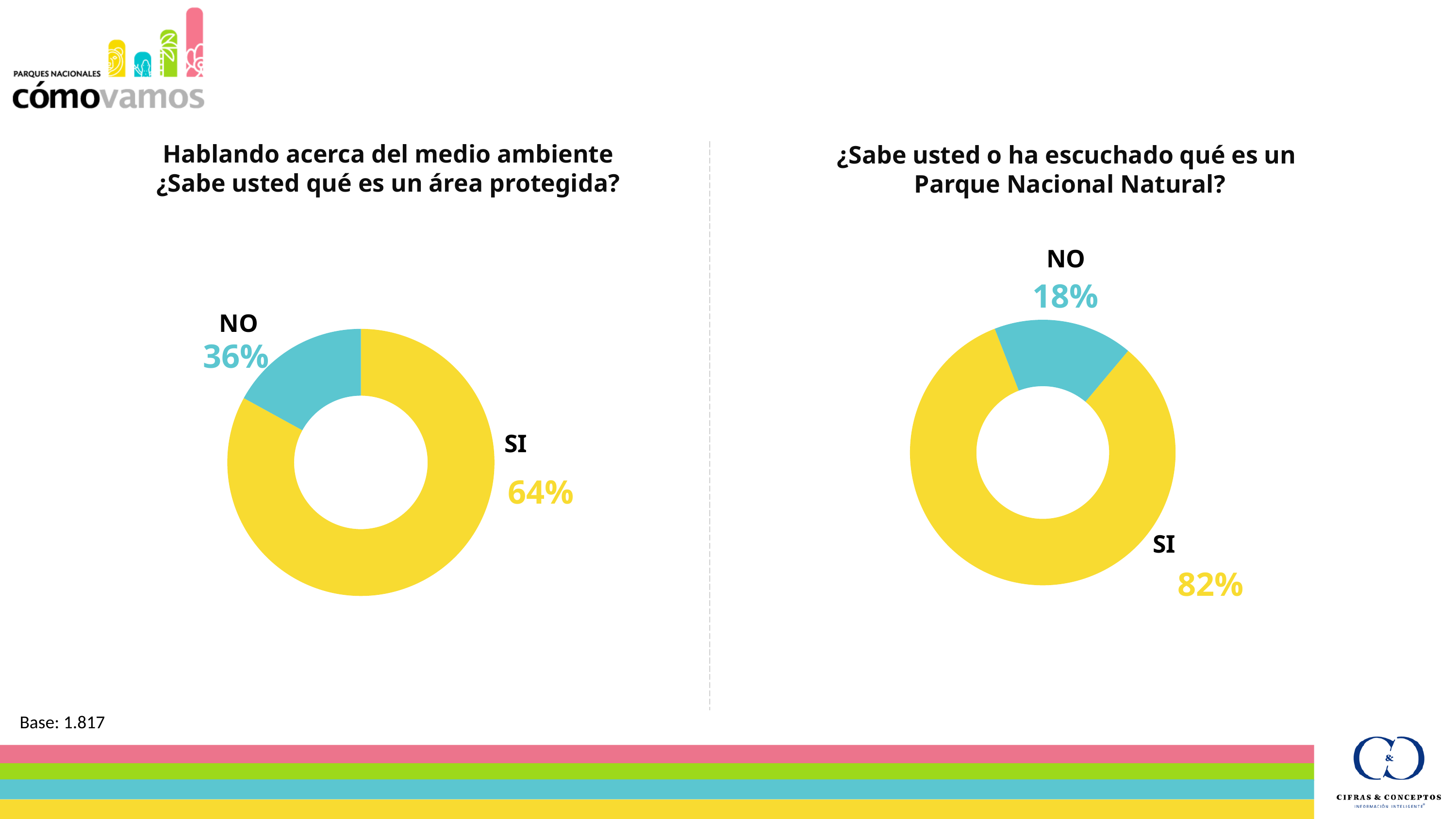
In the left chart (¿Sabe usted qué es un área protegida?), which answer has the largest share? SI In the right chart (¿Sabe usted o ha escuchado qué es un Parque Nacional Natural?), which answer has the smallest share? NO In the left chart (¿Sabe usted qué es un área protegida?), what percentage answered SI? 64% In the right chart (¿Sabe usted o ha escuchado qué es un Parque Nacional Natural?), what percentage answered SI? 82% In the left chart (¿Sabe usted qué es un área protegida?), what is the difference in percentage points between SI and NO? 28 Which chart has the larger SI share, the left chart (área protegida) or the right chart (Parque Nacional Natural)? The right chart (Parque Nacional Natural) In the right chart (¿Sabe usted o ha escuchado qué es un Parque Nacional Natural?), what percentage answered NO? 18% What kind of chart is used on the left side of the slide? Doughnut (pie) chart How many categories does the right chart (¿Sabe usted o ha escuchado qué es un Parque Nacional Natural?) show? 2 What colour represents the NO answer in both charts? Blue (turquoise) In the left chart (¿Sabe usted qué es un área protegida?), what percentage answered NO? 36% In the right chart (¿Sabe usted o ha escuchado qué es un Parque Nacional Natural?), what is the difference in percentage points between SI and NO? 64